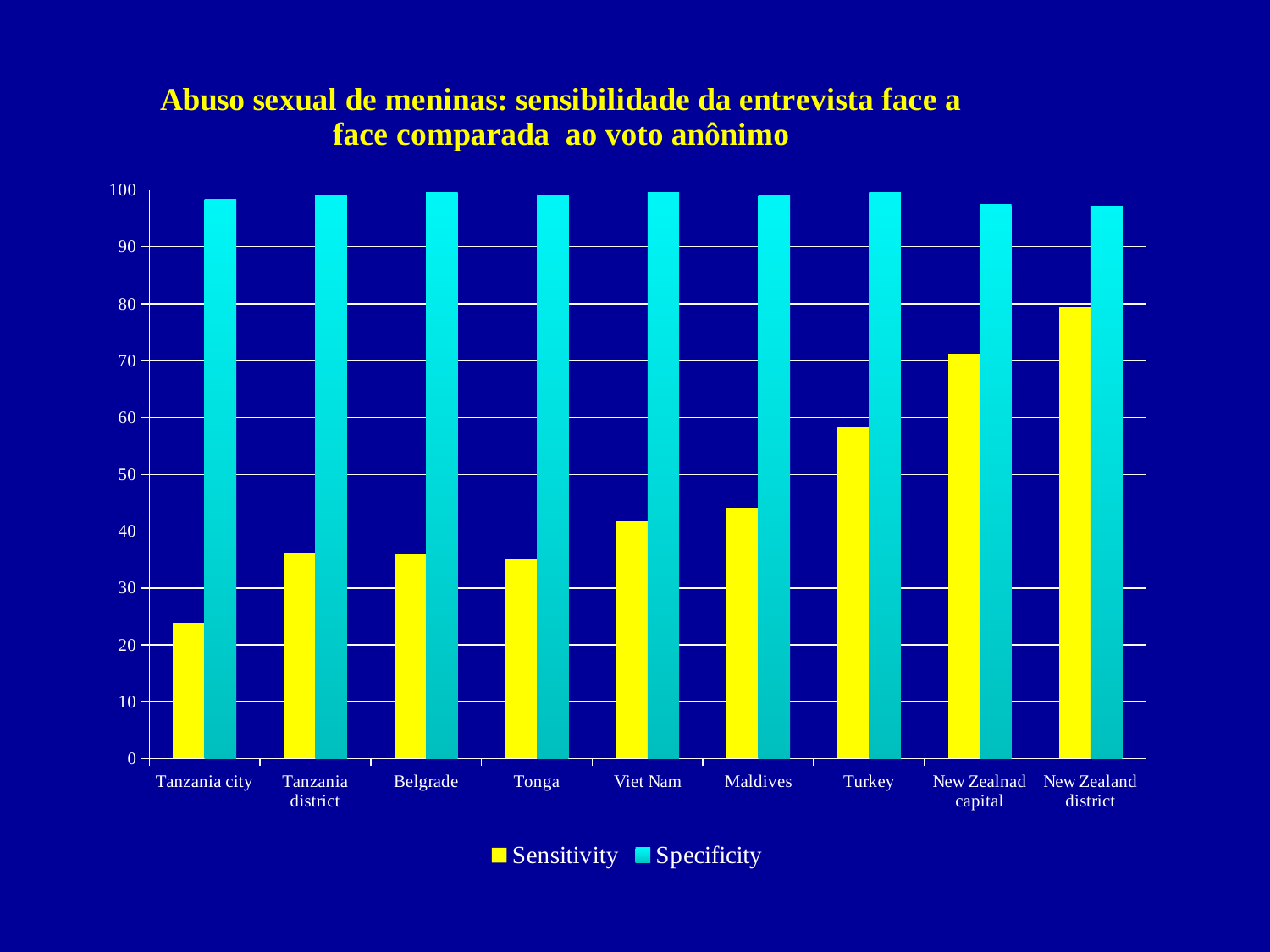
Do the Sensitivity values generally rise or fall from left to right along the x axis? rise What kind of chart is shown on the slide? bar chart How many categories are shown on the x axis? 9 For Tonga, which is larger, Sensitivity or Specificity? Specificity Which category has the lowest Sensitivity value? Tanzania city Is the Sensitivity value for Turkey greater or less than 50? greater Is the Sensitivity value for Belgrade greater or less than 40? less Which category has the highest Sensitivity value? New Zealand district Is the Sensitivity value for Tanzania city greater or less than 30? less How many series does the legend list? 2 Which is larger, the Sensitivity value for Turkey or the Sensitivity value for Maldives? Turkey